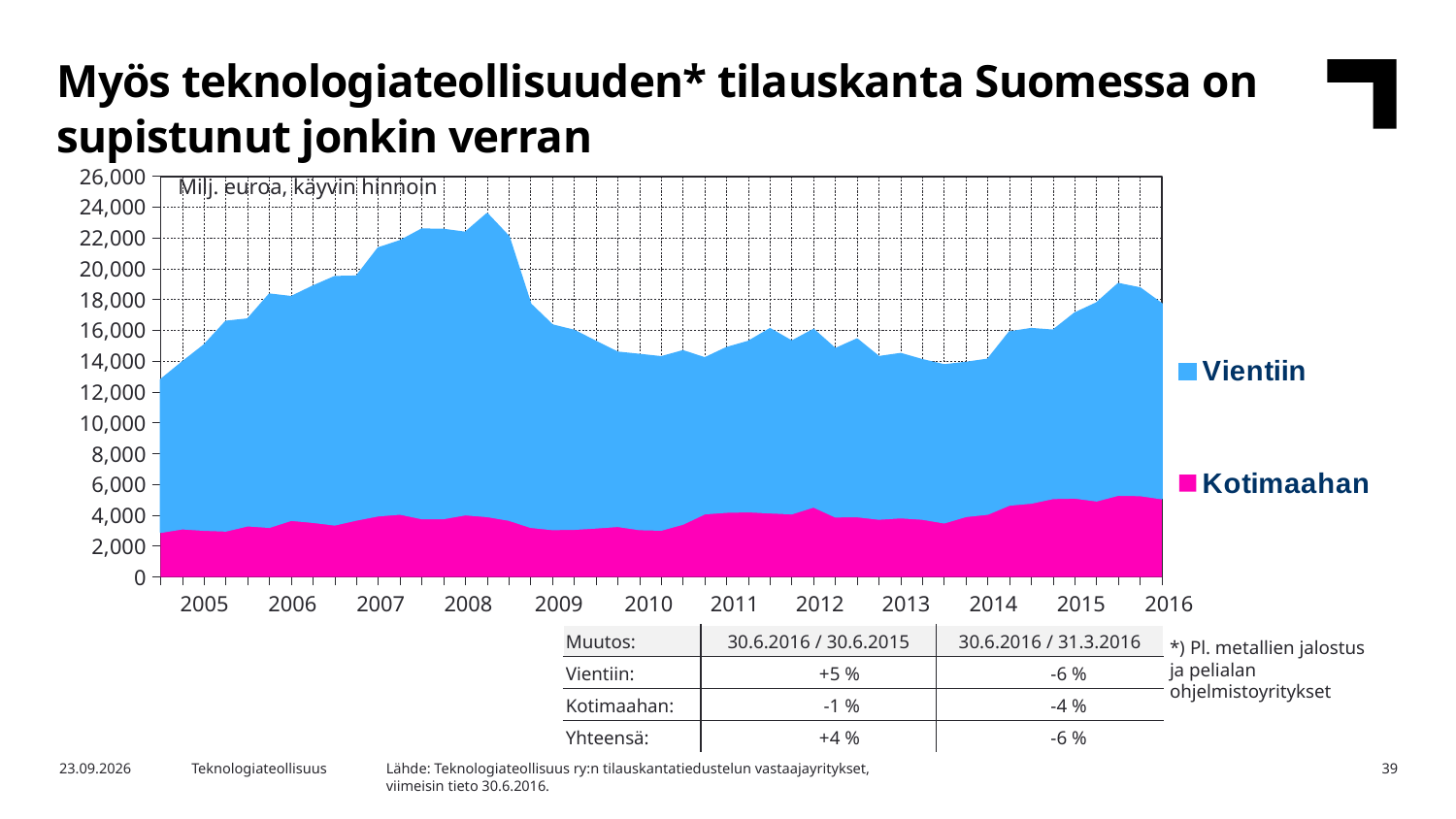
Does the total order stock rise or fall between 2008 and 2009? fall How many series does the chart legend list? 2 Is the total order stock at its 2008 peak greater or less than 22,000? greater Which series is larger throughout the chart, Vientiin or Kotimaahan? Vientiin What unit label is printed inside the chart area? Milj. euroa, käyvin hinnoin Is the total order stock at the end of the chart (2016) greater or less than 20,000? less Does the total order stock rise or fall between 2005 and 2008? rise Is the Kotimaahan value at the end of the chart (2016) greater or less than 4,000? greater How many years are labelled on the x axis of the chart? 12 What kind of chart is shown on the slide? Stacked area chart What are the two series named in the chart legend? Vientiin and Kotimaahan